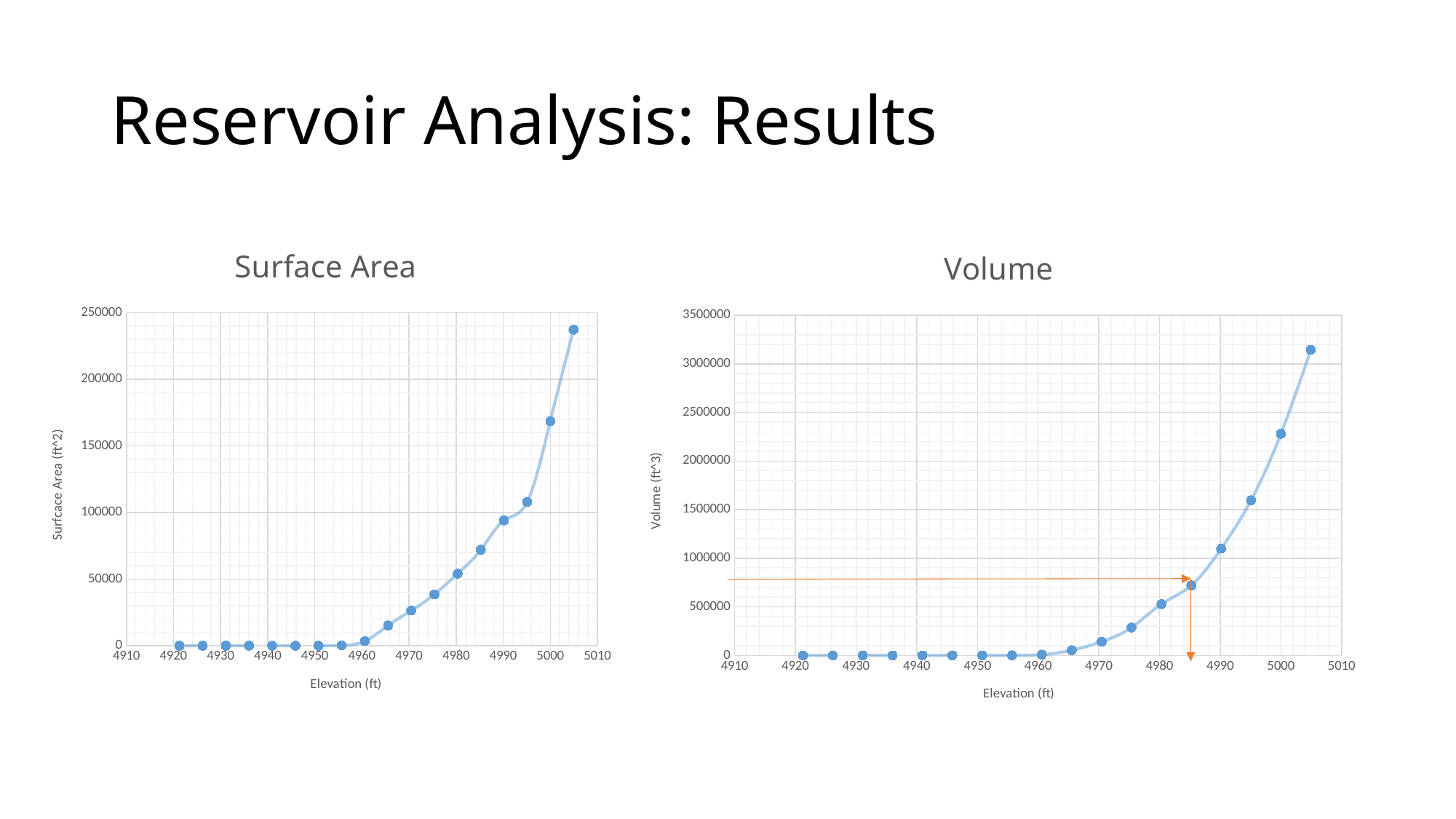
In the Surface Area chart, is the value at elevation 5005 greater or less than 200000? greater In the Volume chart, do the values rise or fall as elevation increases along the x axis? rise In the Surface Area chart, is the value at elevation 5000 greater or less than 150000? greater What kind of chart is the Surface Area chart? line chart In the Volume chart, is the value at elevation 5000 greater or less than 2000000? greater What is the y-axis label of the Volume chart? Volume (ft^3) In the Surface Area chart, which is larger: the value at elevation 4995 or the value at elevation 5000? 5000